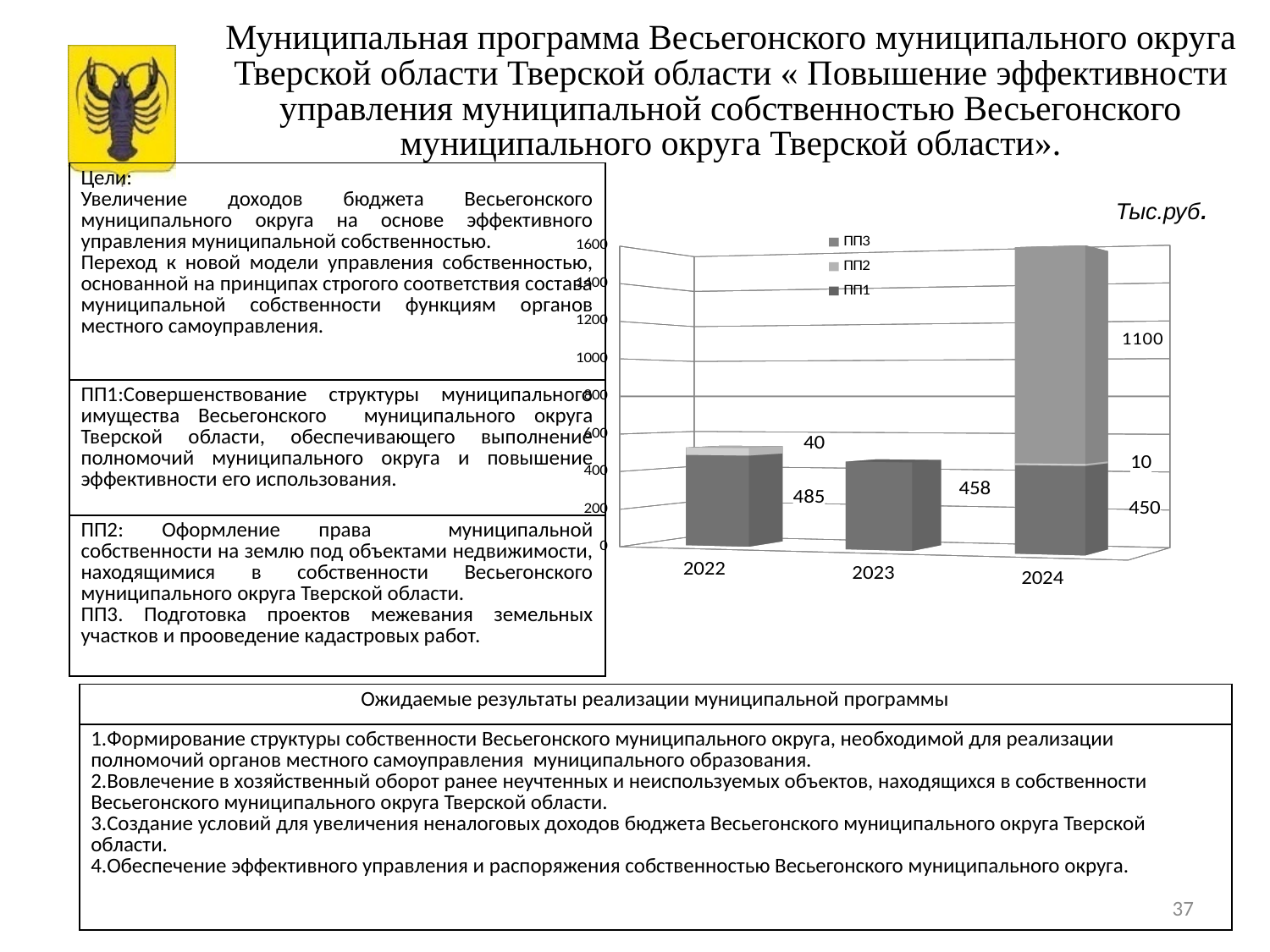
What kind of chart is shown on the slide? bar chart What is the value of ПП2 for 2024? 10 How many series does the chart legend list? 3 What is the difference between the ПП1 values for 2022 and 2023? 27 What is the total of the stacked bar for 2024? 1560 How many years are shown on the x axis of the chart? 3 What is the value of ПП2 for 2022? 40 What is the value of ПП1 for 2022? 485 What is the value of ПП1 for 2023? 458 What is the value of ПП3 for 2024? 1100 Which year has the tallest stacked bar? 2024 What is the value of ПП1 for 2024? 450